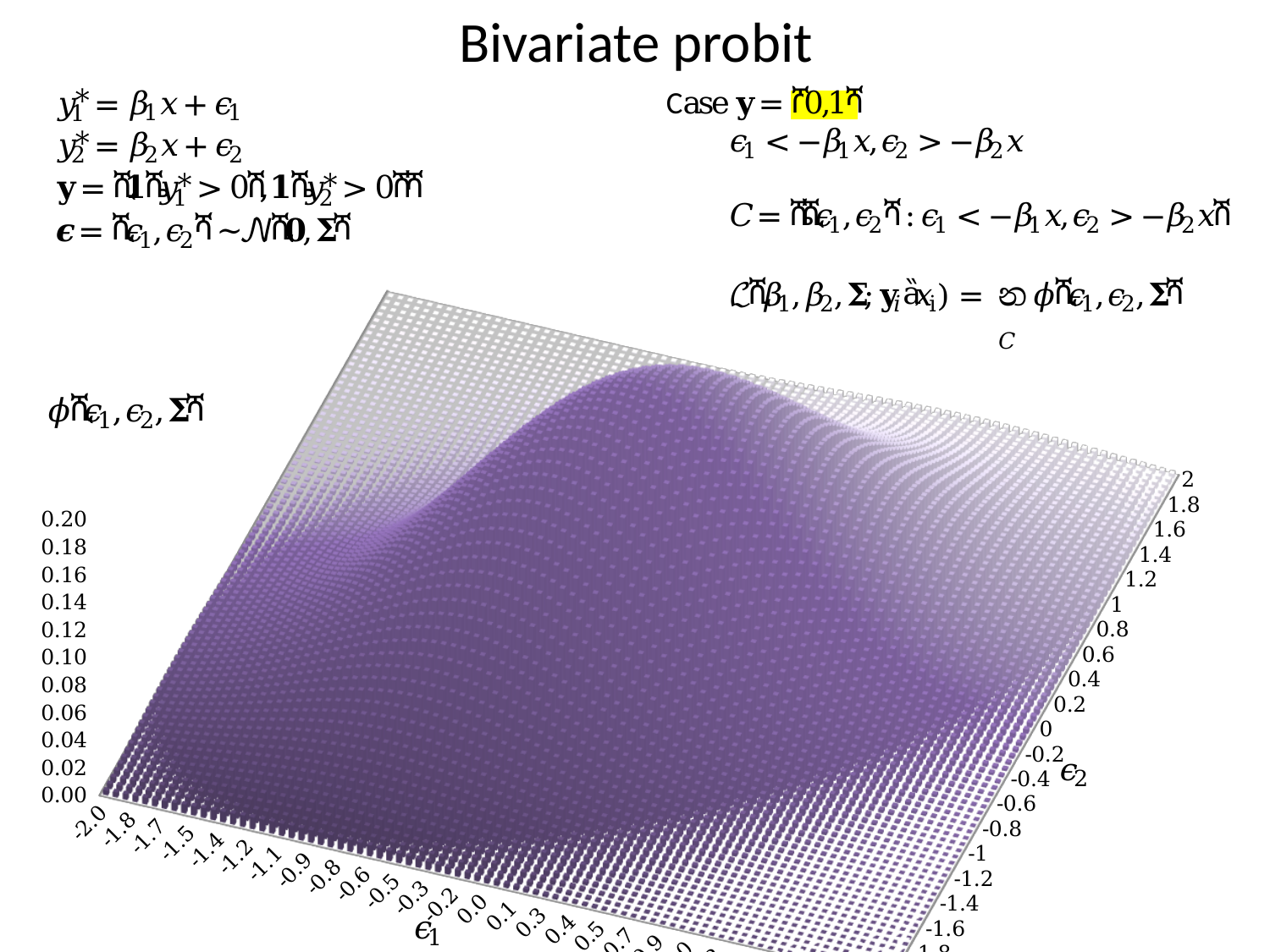
Is the peak value of the plotted surface greater or less than 0.10? greater What kind of chart is shown on the slide? 3D surface chart Is the value of the surface at the corner where ε1 = -2.0 and ε2 = -1.8 greater or less than 0.04? less What is the highest tick value shown on the vertical axis of the surface chart? 0.20 Which two variables label the horizontal axes of the surface chart? ε1 and ε2